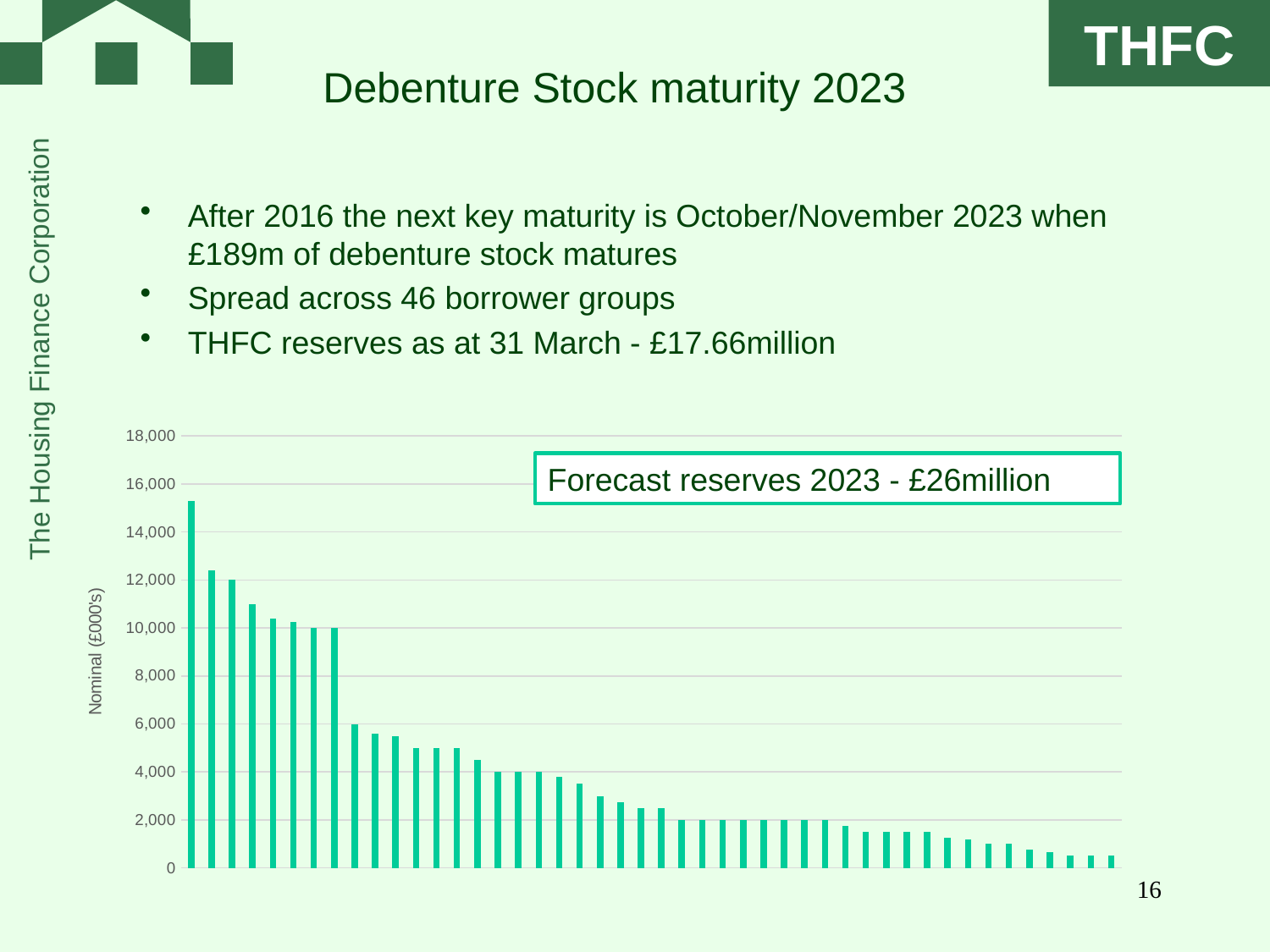
Is the value of the tallest bar in the chart greater or less than 16,000? less Is the value of the shortest bar (rightmost) in the chart greater or less than 2,000? less Is the value of the second bar from the left greater or less than 12,000? greater What kind of chart is shown on the slide? bar chart Do the bar values rise or fall from left to right across the chart? fall What is the label on the vertical axis of the chart? Nominal (£000's) What is the highest value shown on the vertical axis of the chart? 18,000 Which bar is the tallest in the chart, the leftmost or the rightmost? leftmost How many bars are plotted in the chart? 46 What forecast reserves figure for 2023 is shown in the box on the chart? £26million